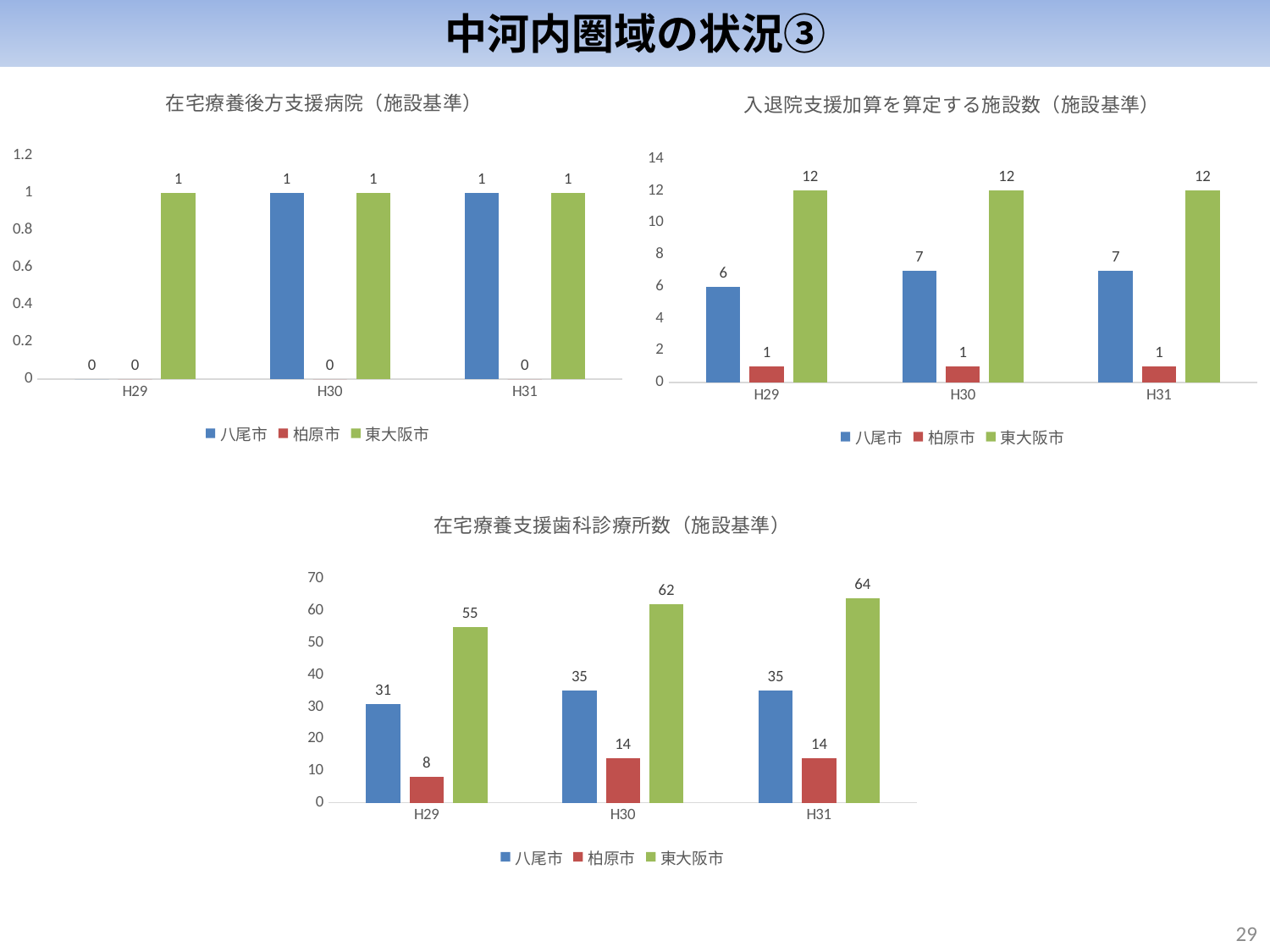
In the chart titled 入退院支援加算を算定する施設数（施設基準）, what is the difference between 東大阪市 and 八尾市 in H30? 5 In the chart titled 在宅療養支援歯科診療所数（施設基準）, what is the value for 東大阪市 in H31? 64 What kind of chart is the chart titled 在宅療養後方支援病院（施設基準）? bar chart In the chart titled 在宅療養後方支援病院（施設基準）, what is the value for 八尾市 in H29? 0 In the chart titled 在宅療養支援歯科診療所数（施設基準）, what is the difference between 東大阪市 and 八尾市 in H31? 29 In the chart titled 在宅療養支援歯科診療所数（施設基準）, which city has the highest value in H30? 東大阪市 In the chart titled 在宅療養支援歯科診療所数（施設基準）, which city has the lowest value in H29? 柏原市 In the chart titled 入退院支援加算を算定する施設数（施設基準）, what is the value for 八尾市 in H29? 6 How many series does the legend list in the chart titled 在宅療養支援歯科診療所数（施設基準）? 3 In the chart titled 入退院支援加算を算定する施設数（施設基準）, which is larger: 八尾市 in H29 or 八尾市 in H31? 八尾市 in H31 How many year categories are shown on the x axis of the chart titled 入退院支援加算を算定する施設数（施設基準）? 3 In the chart titled 在宅療養支援歯科診療所数（施設基準）, does the value for 東大阪市 rise or fall from H29 to H31? rise